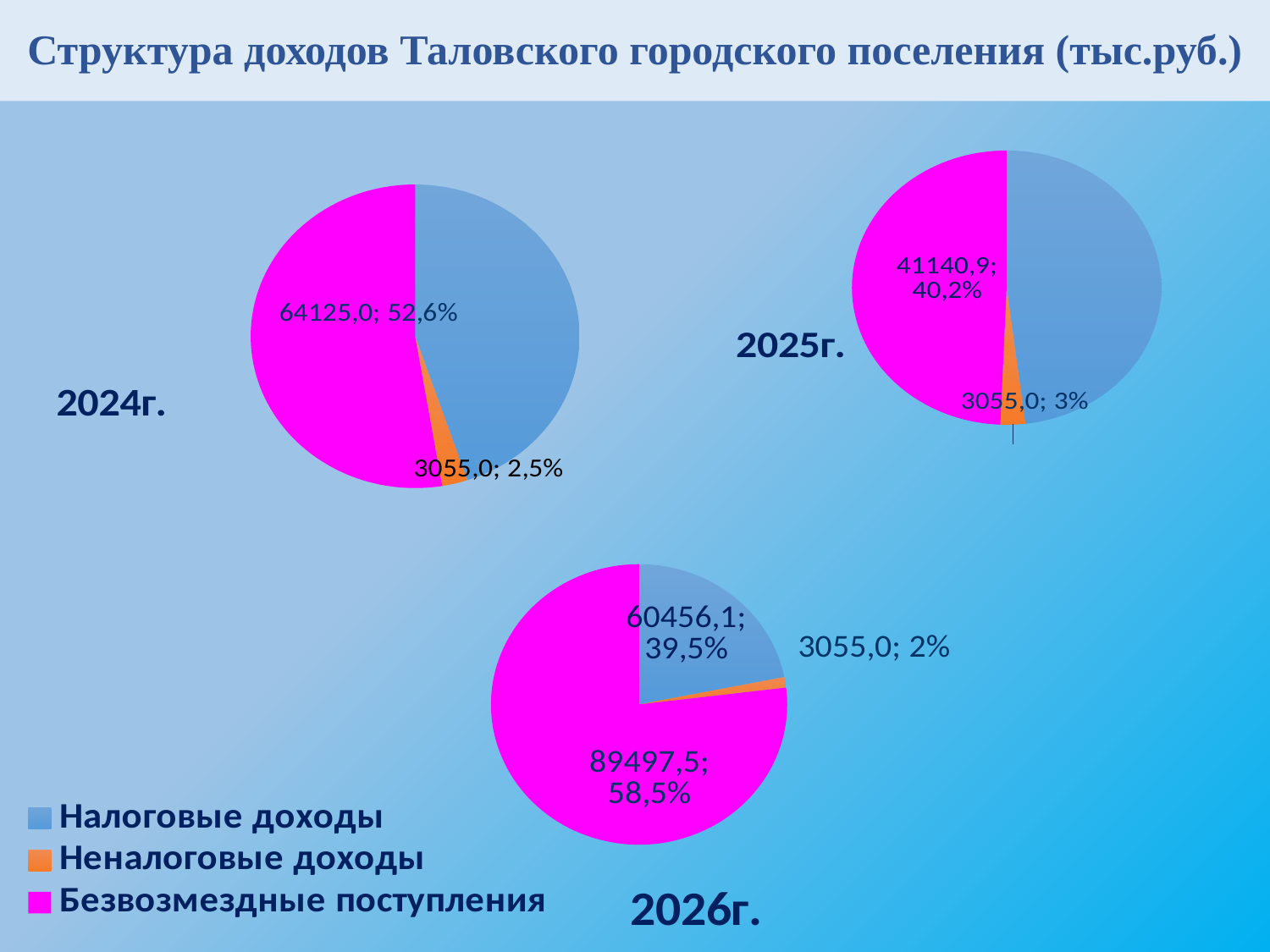
In the 2026г. pie chart, what share does Неналоговые доходы have? 2% How many pie charts are on the slide? 3 In the 2024г. pie chart, what is the value for Неналоговые доходы? 3055,0 In the 2026г. pie chart, how much larger is the value for Безвозмездные поступления than the value for Налоговые доходы? 29041,4 In the 2025г. pie chart, what share does Неналоговые доходы have? 3% How many categories does the legend list? 3 In the 2026г. pie chart, which category has the largest slice? Безвозмездные поступления In the 2026г. pie chart, what is the value for Безвозмездные поступления? 89497,5 What kind of charts are shown on the slide? Pie charts In the 2024г. pie chart, what share does Безвозмездные поступления have? 52,6% In the 2026г. pie chart, what is the value for Налоговые доходы? 60456,1